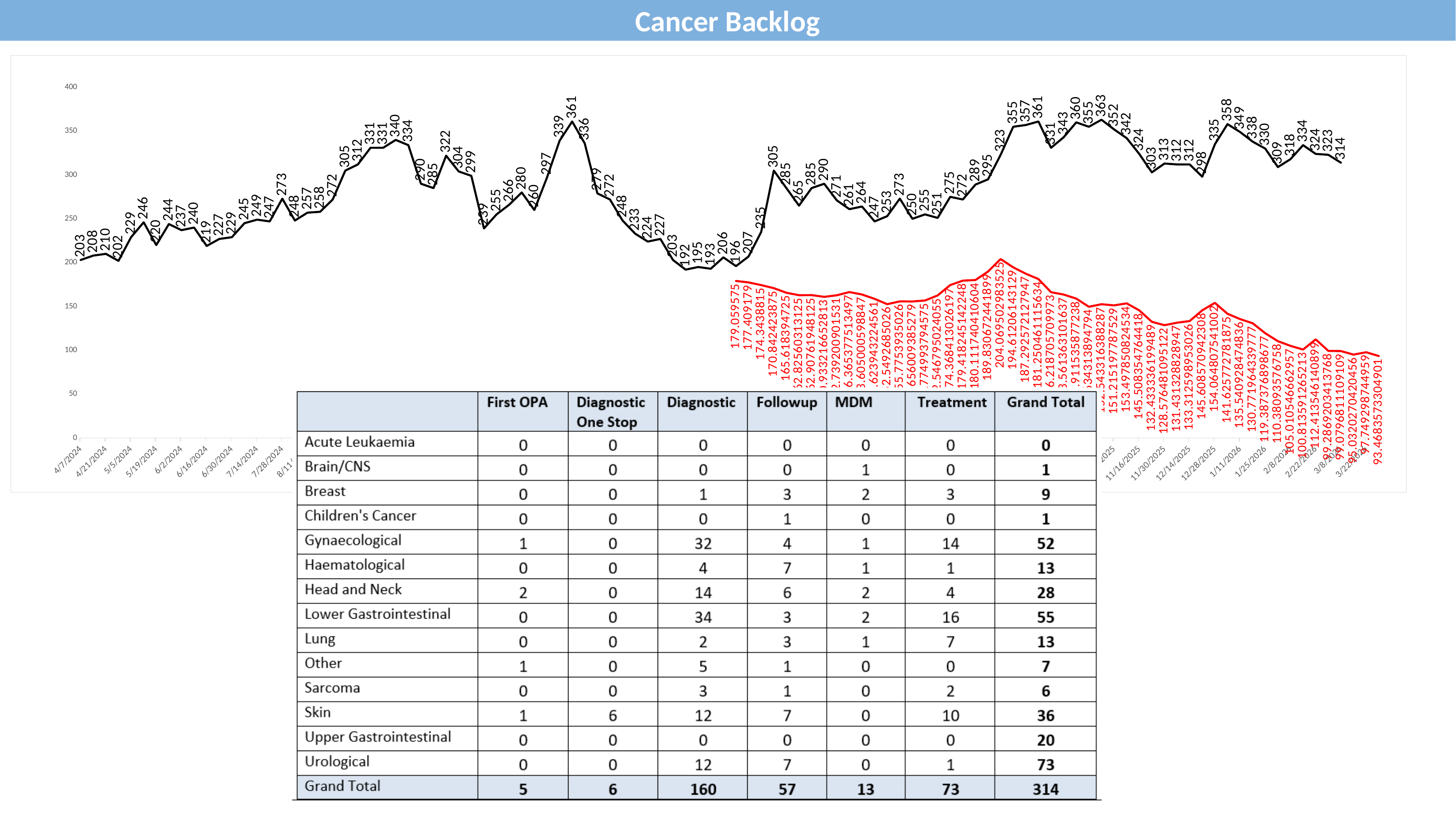
What is the difference between the highest (363) and lowest (192) values labelled on the black line? 171 What is the value of the black line at the first date, 4/7/2024? 203 What kind of chart is shown on the slide? line chart Is the highest point of the red line greater or less than 200? greater How many lines are plotted on the chart? 2 What is the highest value labelled on the black line of the chart? 363 Is the final value of the red line greater or less than 100? less Overall, does the black line rise or fall from the first date to the last date? rise Which is larger on the black line: the peak labelled 361 or the peak labelled 305? 361 What is the lowest value labelled on the black line of the chart? 192 By how much does the black line's final value (314) exceed its first value (203)? 111